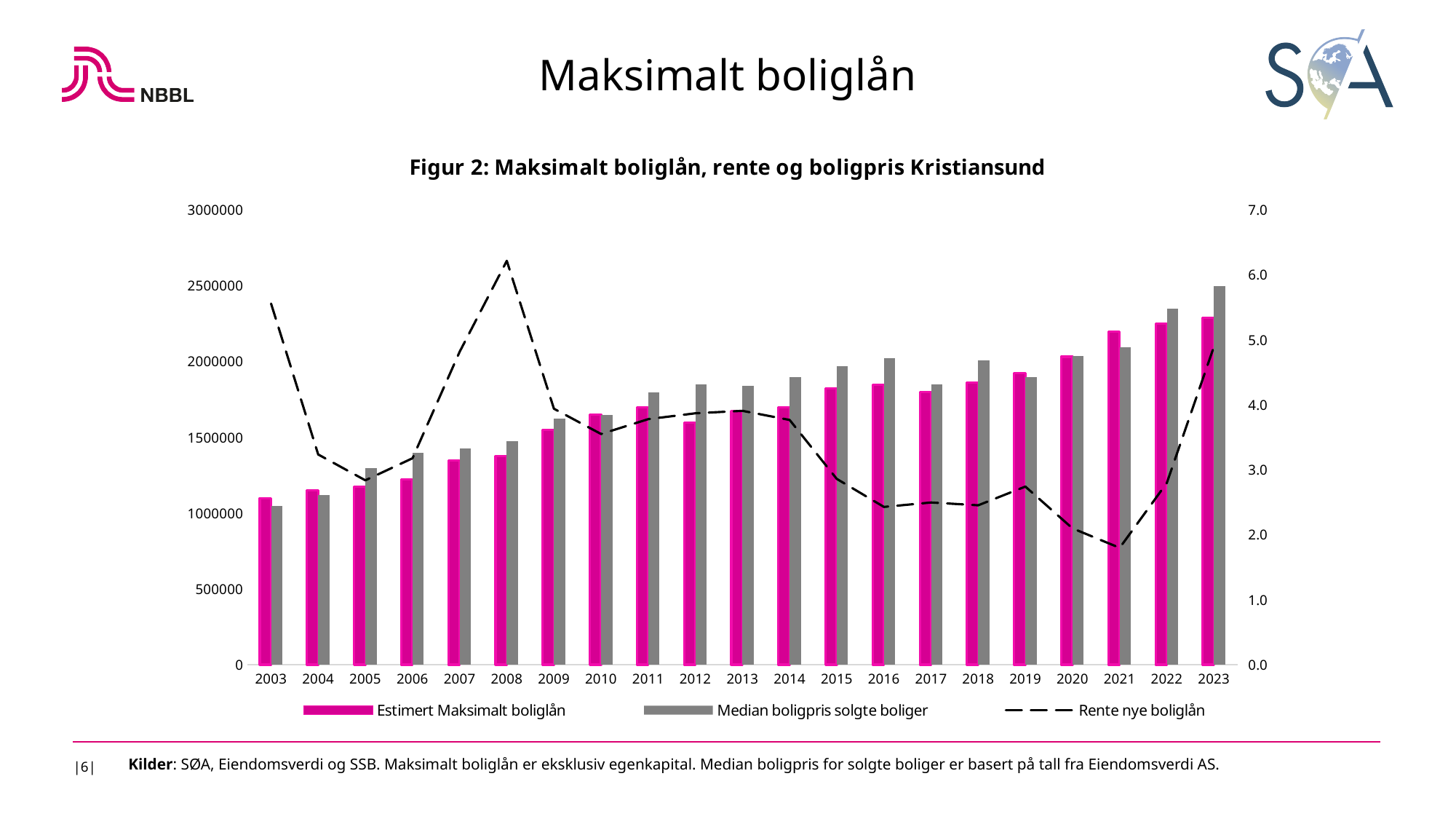
In 2023, which is larger: Estimert Maksimalt boliglån or Median boligpris solgte boliger? Median boligpris solgte boliger In which year is Median boligpris solgte boliger highest? 2023 What is the title of the chart? Figur 2: Maksimalt boliglån, rente og boligpris Kristiansund Is the value for Rente nye boliglån in 2021 greater or less than 3.0? less Does Estimert Maksimalt boliglån generally rise or fall from 2003 to 2023? rise Is the value for Estimert Maksimalt boliglån in 2023 greater or less than 2000000? greater How many years are shown on the x axis of the chart? 21 How many series does the legend list? 3 Is the value for Rente nye boliglån in 2008 greater or less than 5.0? greater In which year is Estimert Maksimalt boliglån lowest? 2003 What kind of chart is shown in Figur 2? A combined bar and line chart